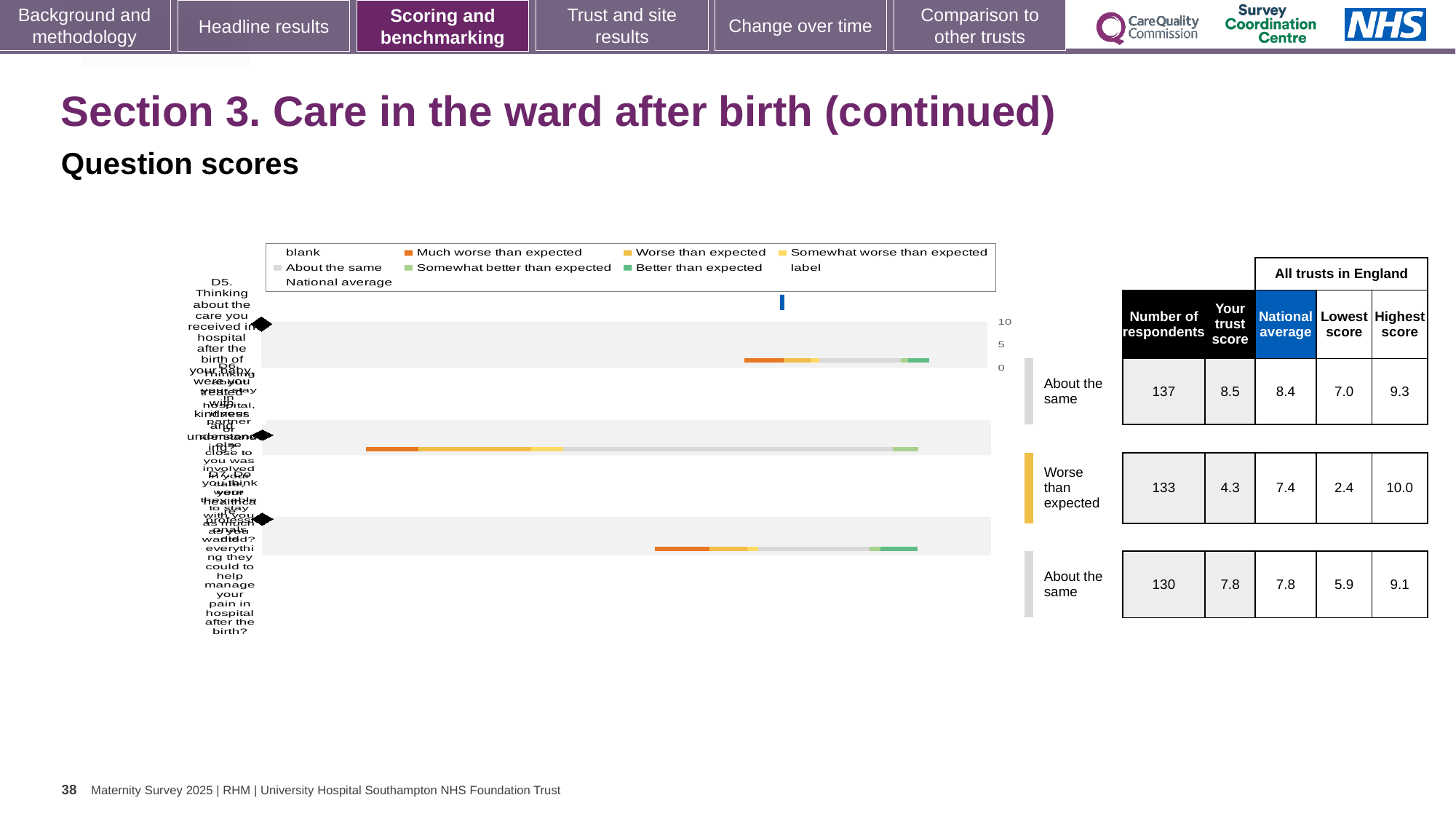
In the table next to the chart, what is the highest score for the row rated 'Worse than expected'? 10.0 What kind of chart is shown on the slide? bar chart In the table next to the chart, what is the difference between the national average and 'Your trust score' for the row rated 'Worse than expected'? 3.1 In the chart legend, which colour represents 'Much worse than expected'? orange How many question rows (bars) are plotted in the chart? 3 In the chart legend, which colour represents 'Better than expected'? green In the table next to the chart, which row has the lowest 'Your trust score'? Worse than expected (second row) In the table next to the chart, what is 'Your trust score' for the row rated 'Worse than expected'? 4.3 In the table next to the chart, what is the number of respondents for the second row (the one rated 'Worse than expected')? 133 In the table next to the chart, what is the lowest score for the first row? 7.0 In the table next to the chart, what is the national average for the row rated 'Worse than expected'? 7.4 In the table next to the chart, is 'Your trust score' for the first row larger or smaller than its national average? larger